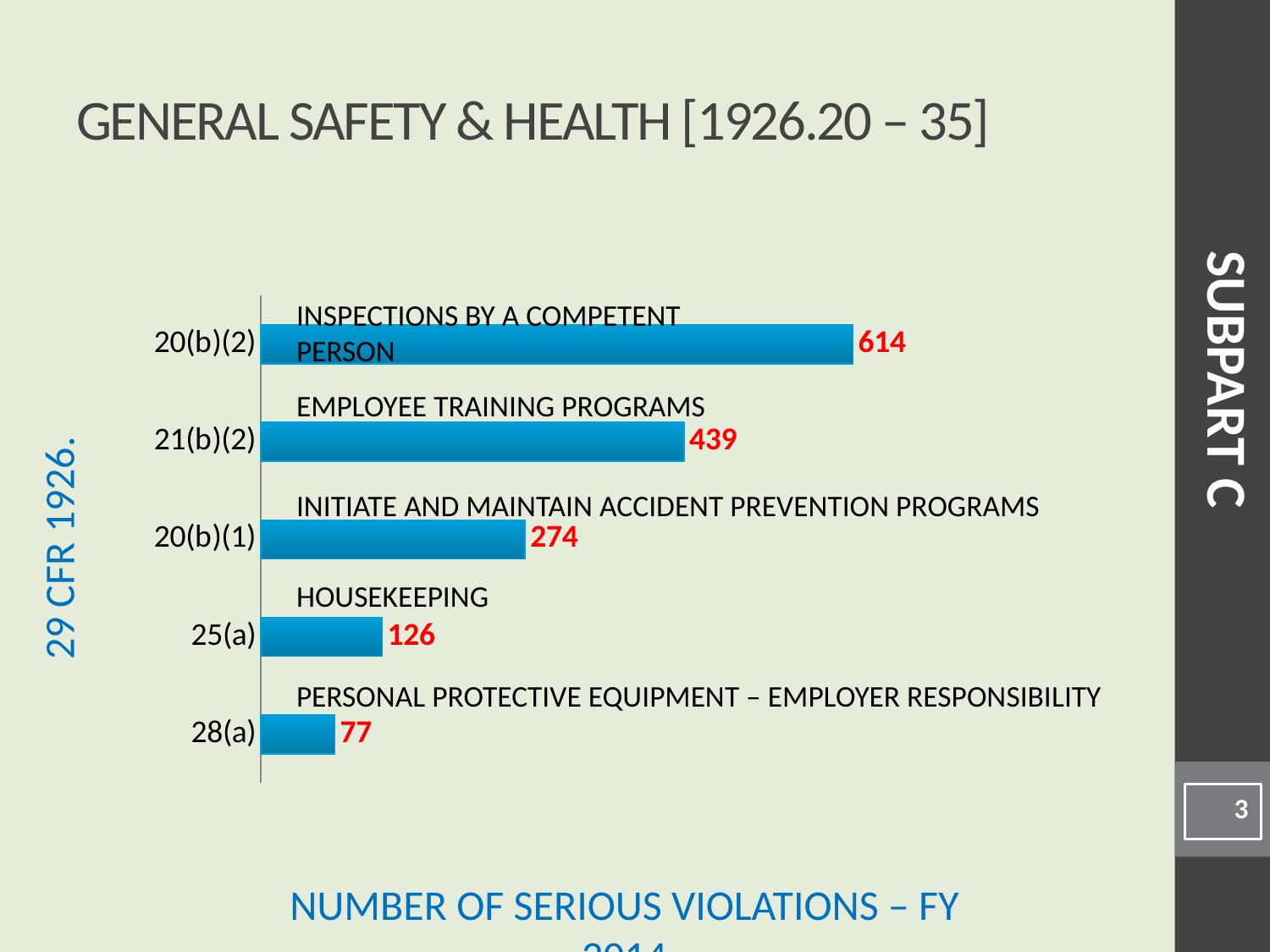
What is the value shown for 28(a), Personal Protective Equipment – Employer Responsibility? 77 Which has a larger value, 20(b)(1) or 25(a)? 20(b)(1) What is the value shown for 21(b)(2), Employee Training Programs? 439 Which category has the lowest number of serious violations? 28(a) Which category has the highest number of serious violations? 20(b)(2) What is the difference between the values for 20(b)(1) and 25(a)? 148 What is the difference between the values for 20(b)(2) and 21(b)(2)? 175 What is the value shown for 25(a), Housekeeping? 126 What colour are the bars in the chart? Blue How many categories are plotted in the chart? 5 What kind of chart is shown on the slide? Bar chart How many serious violations are shown for 20(b)(2), Inspections by a Competent Person? 614